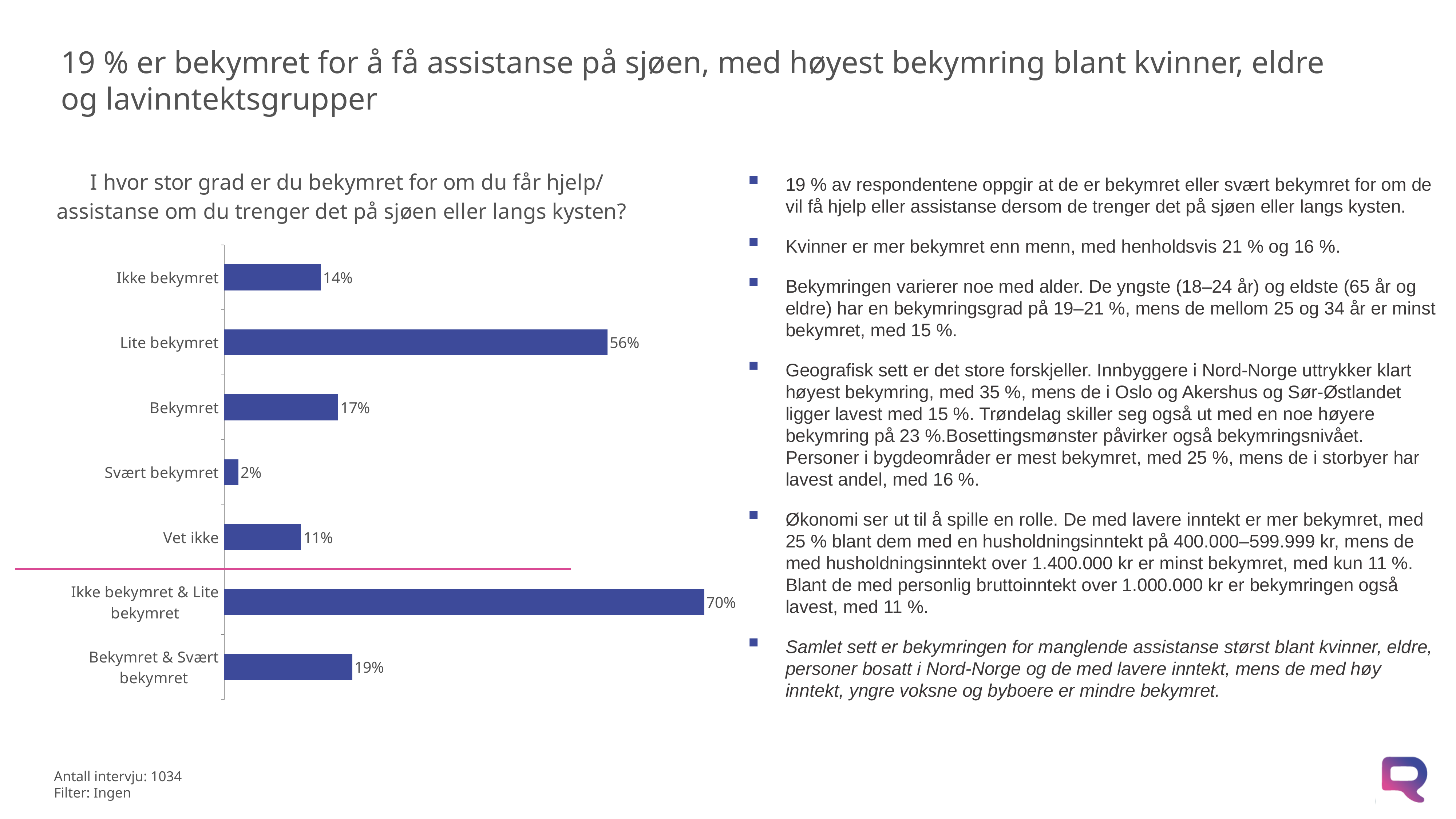
What is the number of interviews (Antall intervju) stated on the slide? 1034 What is the value for "Bekymret & Svært bekymret"? 19% How many categories are shown in the chart? 7 What is the difference between "Ikke bekymret & Lite bekymret" and "Bekymret & Svært bekymret"? 51% What kind of chart is shown on the slide? Bar chart What is the value for "Vet ikke"? 11% What is the difference between "Lite bekymret" and "Ikke bekymret"? 42% Which is larger, "Bekymret" or "Ikke bekymret"? Bekymret What is the value for "Lite bekymret"? 56% Which category has the highest value? Ikke bekymret & Lite bekymret Which category has the lowest value? Svært bekymret What is the value for "Svært bekymret"? 2%